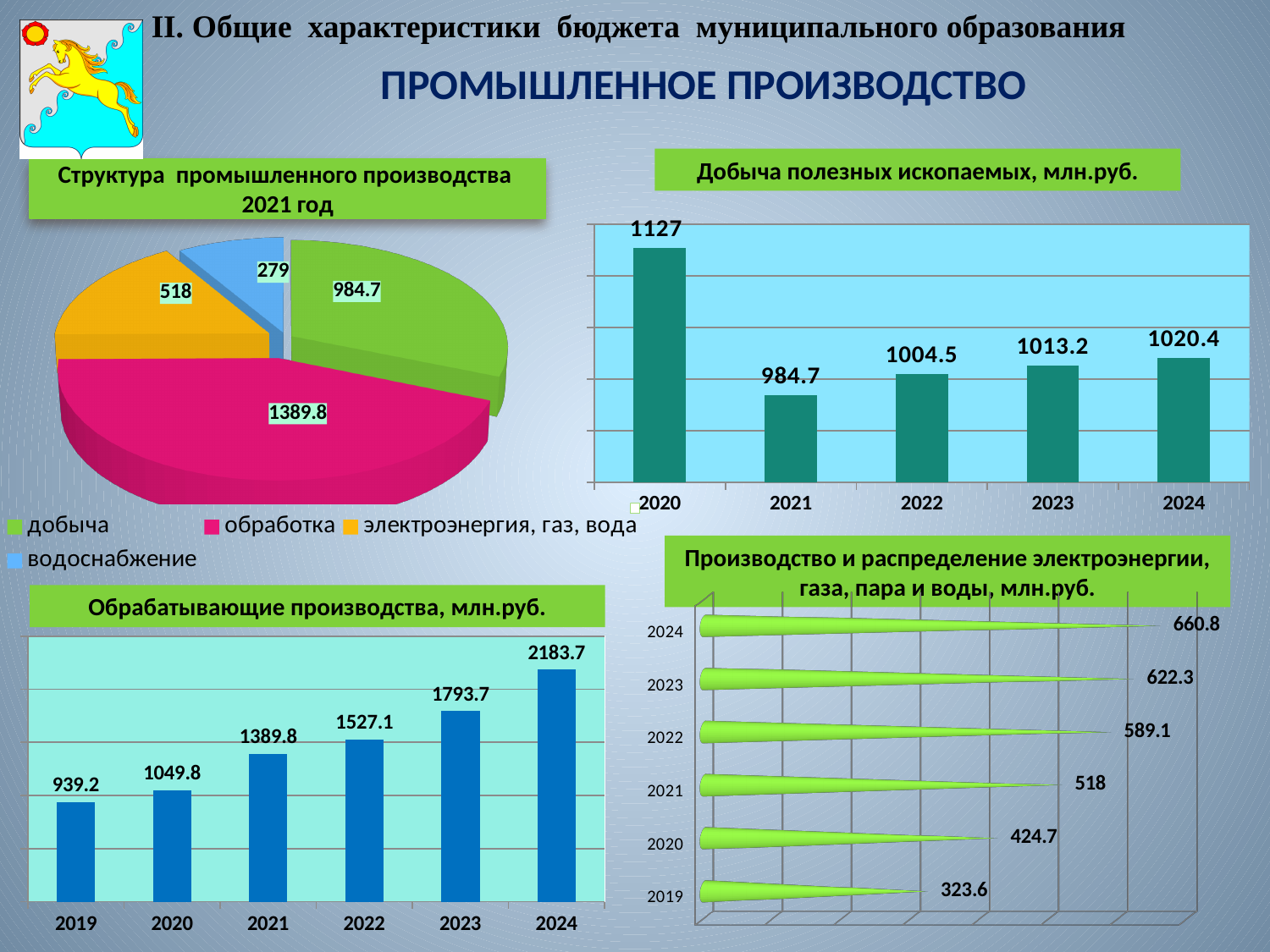
In the chart 'Добыча полезных ископаемых, млн.руб.', what is the difference between the 2020 and 2021 values? 142.3 In the chart 'Обрабатывающие производства, млн.руб.', which year has the highest value? 2024 In the chart 'Обрабатывающие производства, млн.руб.', how many years are shown? 6 In the pie chart 'Структура промышленного производства 2021 год', which category has the smallest slice? водоснабжение In the chart 'Обрабатывающие производства, млн.руб.', do the values rise or fall from 2019 to 2024? rise In the chart 'Обрабатывающие производства, млн.руб.', what is the value for 2023? 1793.7 In the chart 'Производство и распределение электроэнергии, газа, пара и воды, млн.руб.', what is the difference between the 2024 and 2019 values? 337.2 In the pie chart 'Структура промышленного производства 2021 год', what is the value for 'обработка'? 1389.8 What kind of chart is 'Добыча полезных ископаемых, млн.руб.'? bar chart In the chart 'Добыча полезных ископаемых, млн.руб.', which year has the lowest value? 2021 In the chart 'Добыча полезных ископаемых, млн.руб.', what is the value for 2020? 1127 In the chart 'Производство и распределение электроэнергии, газа, пара и воды, млн.руб.', what is the value for 2022? 589.1